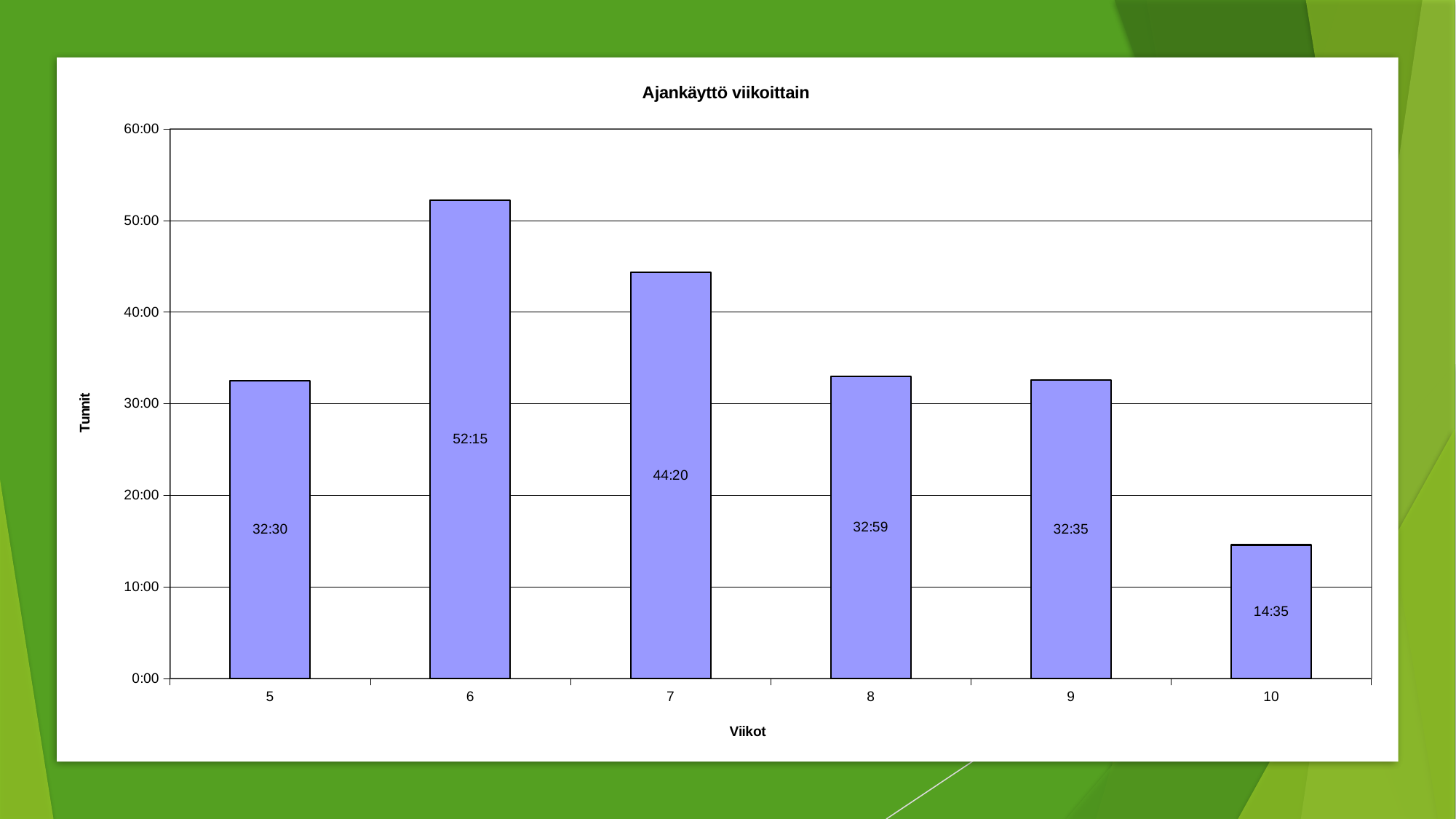
Which week has the highest value? 6 Which is larger, the value for week 7 or the value for week 8? week 7 Is the value for week 10 greater or less than 20:00? less What is the difference between the values for week 6 and week 10? 37:40 Which week has the lowest value? 10 What is the value for week 10? 14:35 What is the title of the chart? Ajankäyttö viikoittain What kind of chart is shown on the slide? bar chart What is the value for week 8? 32:59 What is the difference between the values for week 6 and week 7? 7:55 What is the value for week 6? 52:15 How many weeks are shown on the x axis? 6